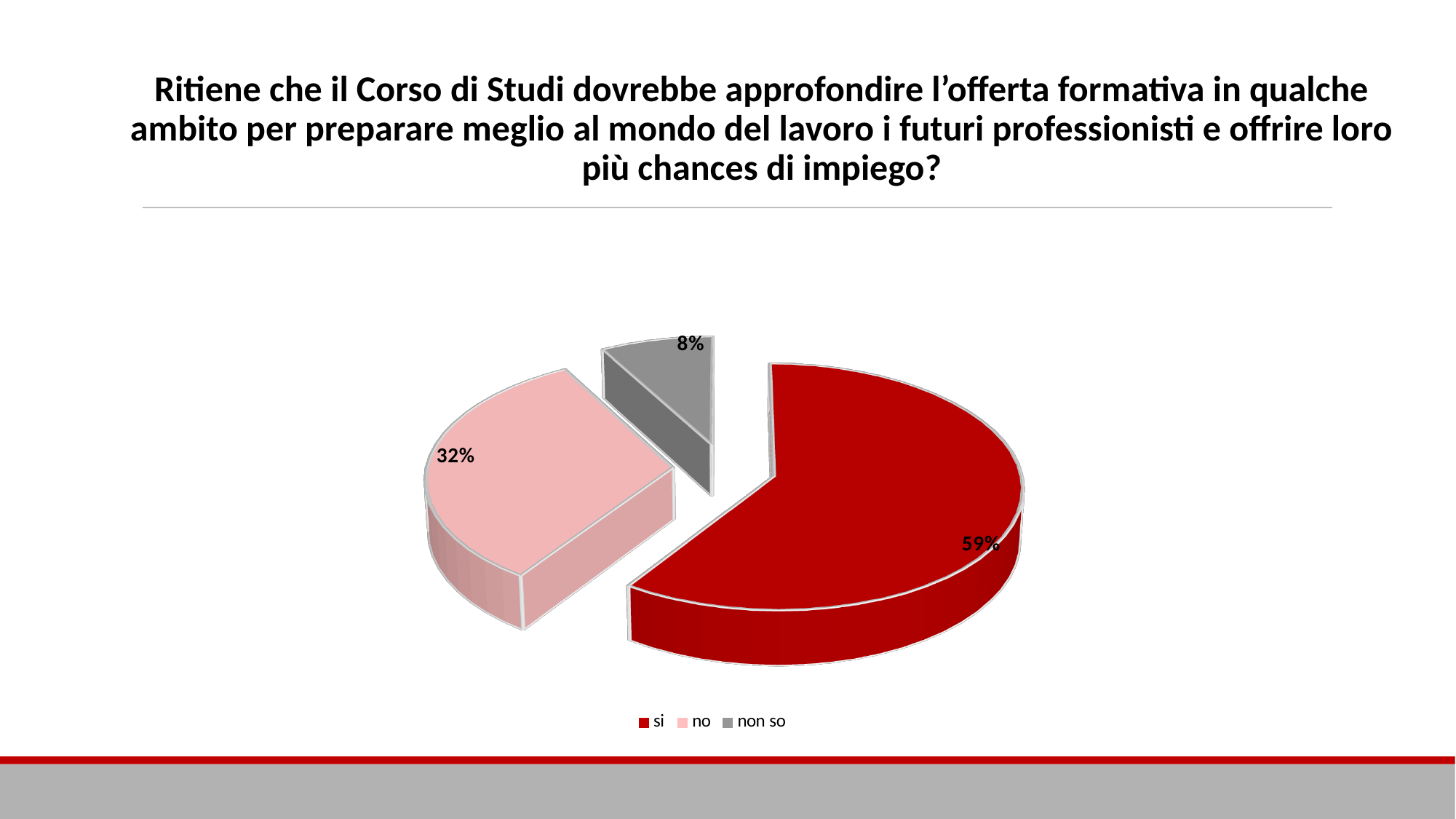
What kind of chart is shown on the slide? pie chart What colour is the "non so" slice? grey Which is larger, the "no" slice or the "non so" slice? no What share of the pie does the "non so" slice represent? 8% Which category has the smallest slice of the pie? non so What is the difference in percentage points between the "si" and "no" slices? 27 What share of the pie does the "no" slice represent? 32% How many categories does the pie chart show? 3 What is the difference in percentage points between the "no" and "non so" slices? 24 Which legend entry is shown in dark red? si Which category has the largest slice of the pie? si What share of the pie does the "si" slice represent? 59%